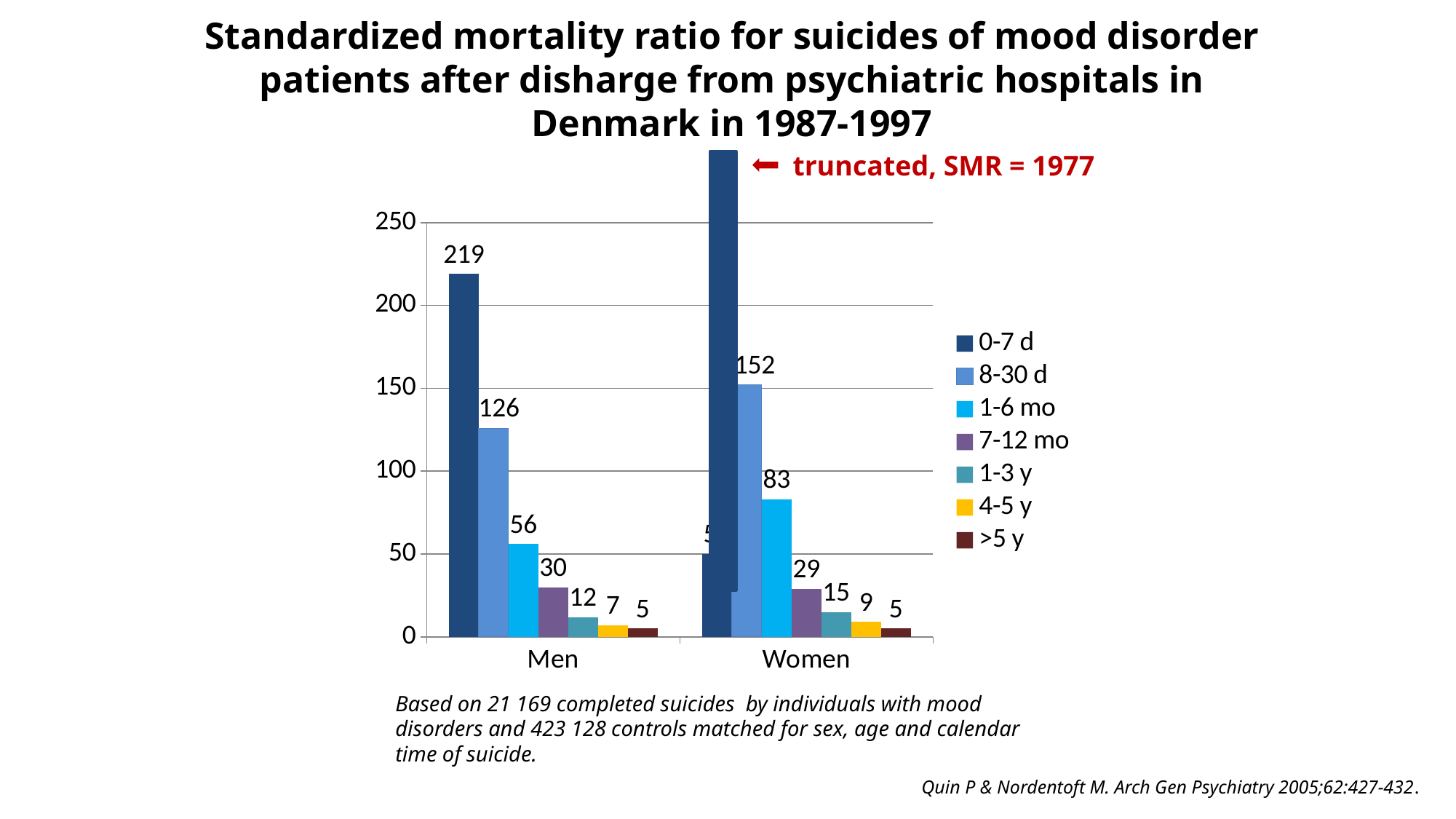
Do the SMR values for men rise or fall as the time since discharge increases? Fall What is the SMR for women in the 8-30 d period? 152 Which is larger, the SMR for men or for women in the 8-30 d period? Women Which time period has the lowest SMR for men? >5 y What is the difference between the SMR for women and men in the 1-6 mo period? 27 What is the SMR for men in the 1-3 y period? 12 What kind of chart is shown on the slide? Bar chart What is the SMR for men in the 0-7 d period? 219 According to the annotation, what is the SMR for the truncated bar for women in the 0-7 d period? 1977 What is the difference between the SMR for men in the 0-7 d period and the 8-30 d period? 93 How many series does the legend list? 7 What is the SMR for women in the 1-6 mo period? 83